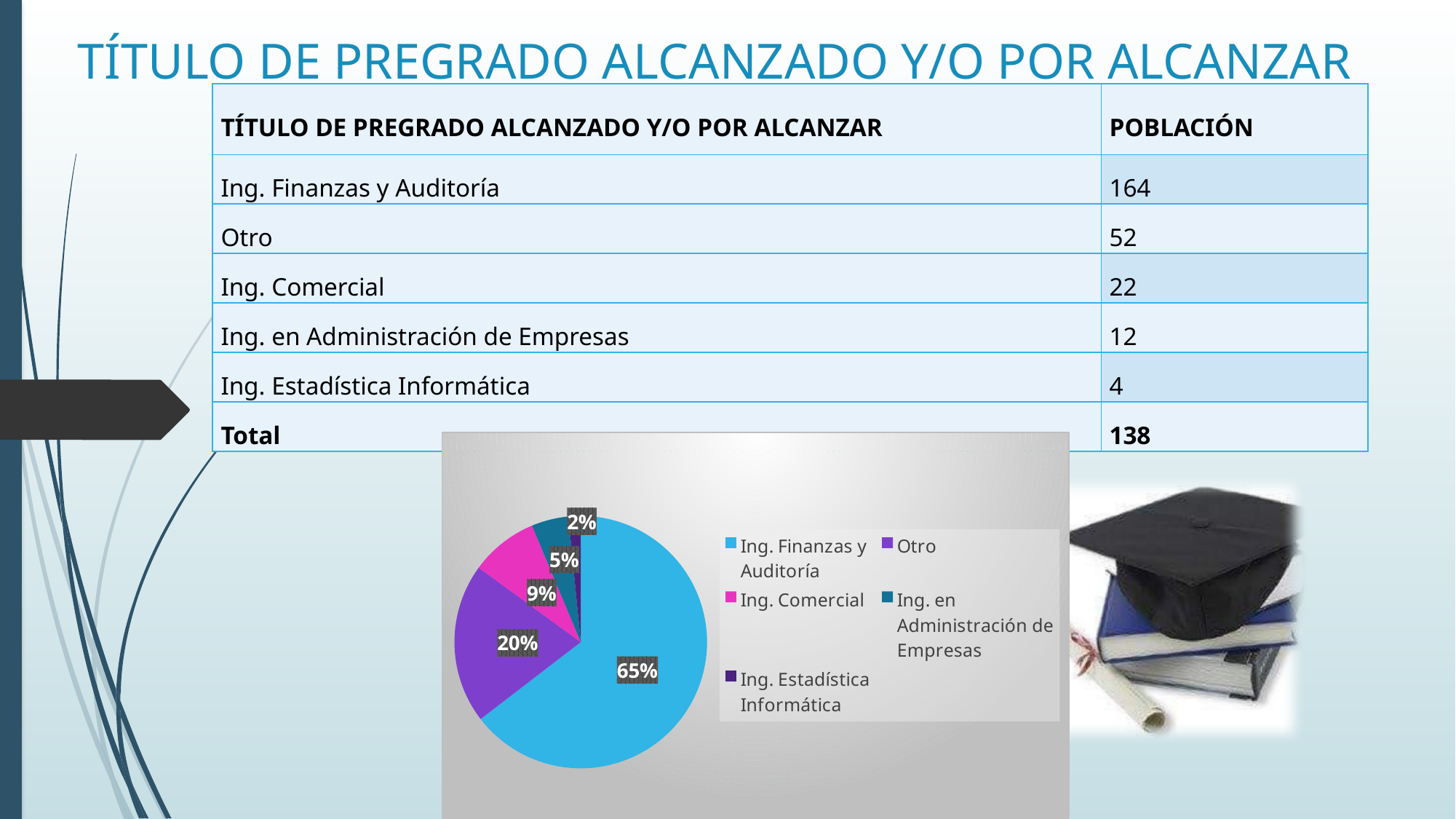
What percentage of the pie chart does Ing. Estadística Informática represent? 2% What percentage of the pie chart does Ing. en Administración de Empresas represent? 5% Which category has the smallest slice in the pie chart? Ing. Estadística Informática What colour is the Otro slice in the pie chart? purple Which category has the largest slice in the pie chart? Ing. Finanzas y Auditoría What is the difference in percentage points between the Ing. Finanzas y Auditoría slice and the Otro slice? 45 What kind of chart is shown on the slide? pie chart How many slices does the pie chart have? 5 Which slice is larger in the pie chart, Ing. Comercial or Ing. en Administración de Empresas? Ing. Comercial What percentage of the pie chart does Ing. Comercial represent? 9%